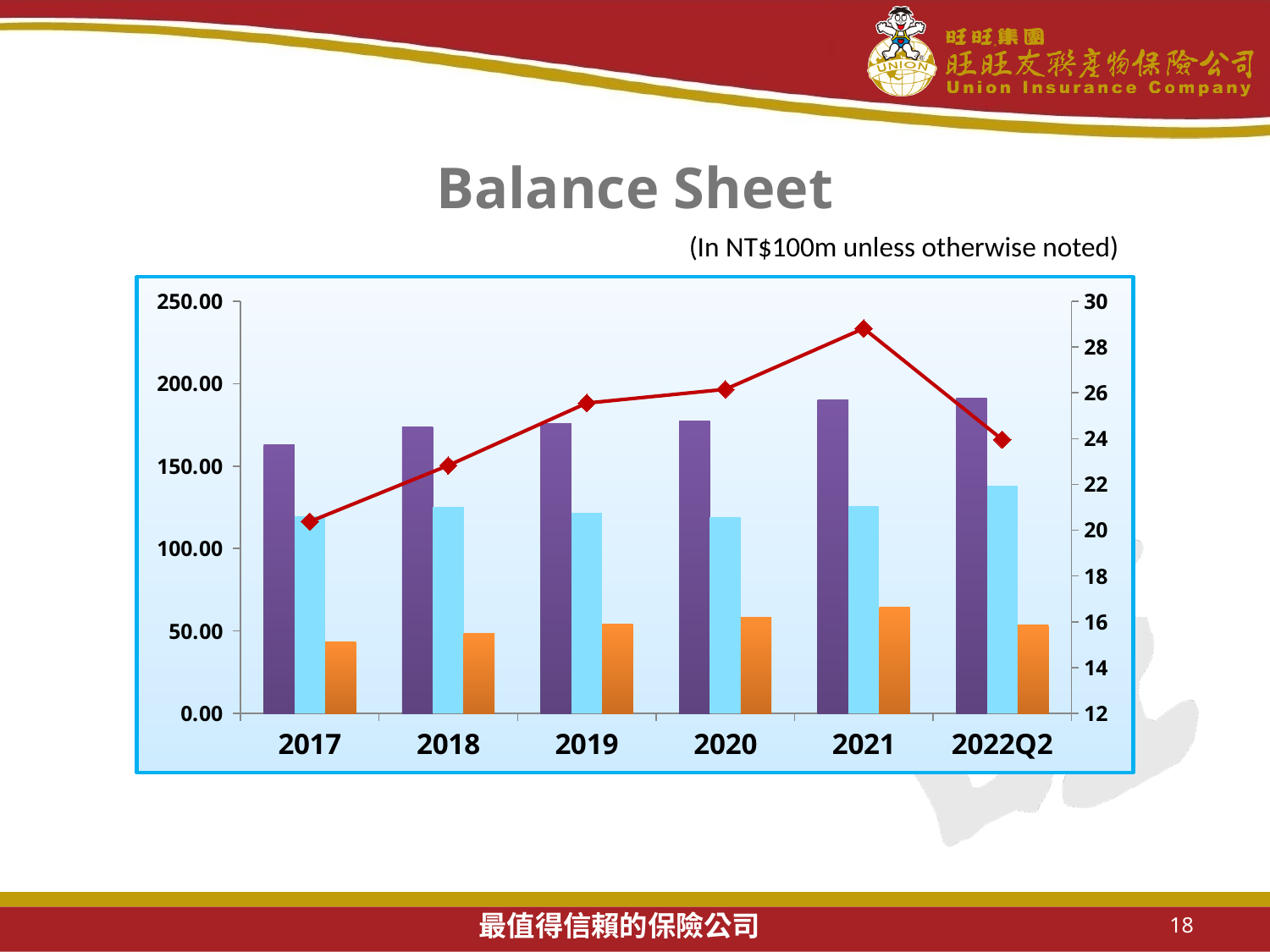
What unit note is printed above the chart? (In NT$100m unless otherwise noted) Is the value of the orange bar for 2017 greater or less than 50.00 on the left axis? less In which year is the red line series at its lowest point? 2017 In which year does the red line series reach its highest point? 2021 Is the value of the purple bar for 2017 greater or less than 150.00 on the left axis? greater In which category is the purple bar the shortest? 2017 In which category is the light blue bar the tallest? 2022Q2 What is the title of the chart on the slide? Balance Sheet How many categories are shown on the x axis of the chart? 6 Does the red line series rise or fall from 2017 to 2021? Rise What kind of chart is shown on the slide? Combined bar and line chart In which category is the orange bar the tallest? 2021